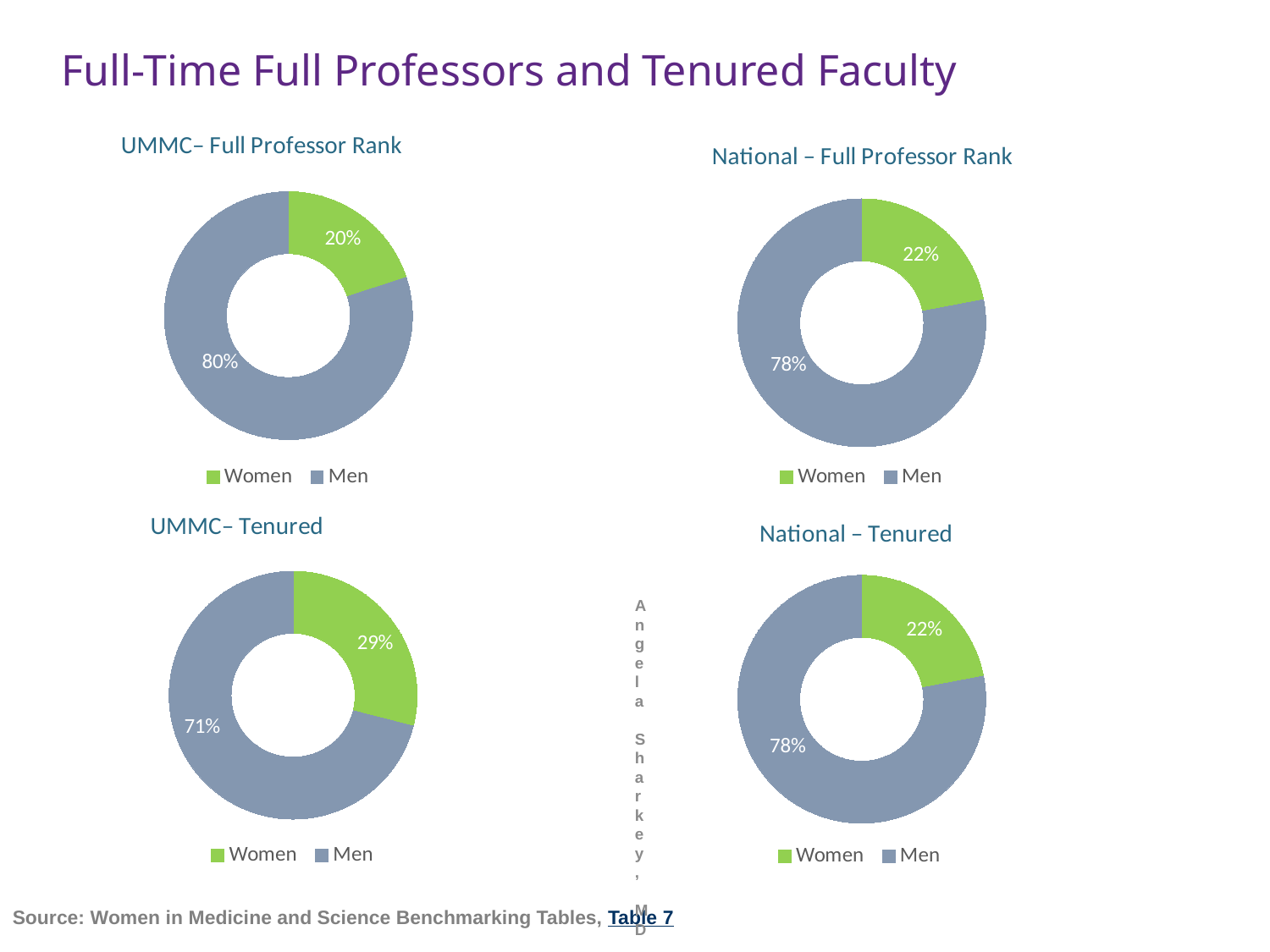
In the 'UMMC– Tenured' chart, what percentage is shown for Women? 29% In the 'National – Full Professor Rank' chart, what percentage is shown for Women? 22% In the 'UMMC– Full Professor Rank' chart, what percentage is shown for Men? 80% In the 'UMMC– Tenured' chart, what percentage is shown for Men? 71% In the 'UMMC– Full Professor Rank' chart, what is the difference between the Men and Women percentages? 60% How many entries does the legend of the 'National – Tenured' chart list? 2 In the 'UMMC– Tenured' chart, which category has the largest share? Men In the 'National – Tenured' chart, what percentage is shown for Men? 78% In the 'National – Full Professor Rank' chart, which category has the smallest share? Women Is the Women share larger in the 'UMMC– Tenured' chart or in the 'National – Tenured' chart? UMMC– Tenured What type of chart is the 'UMMC– Full Professor Rank' chart? Doughnut chart In the 'UMMC– Full Professor Rank' chart, what percentage is shown for Women? 20%